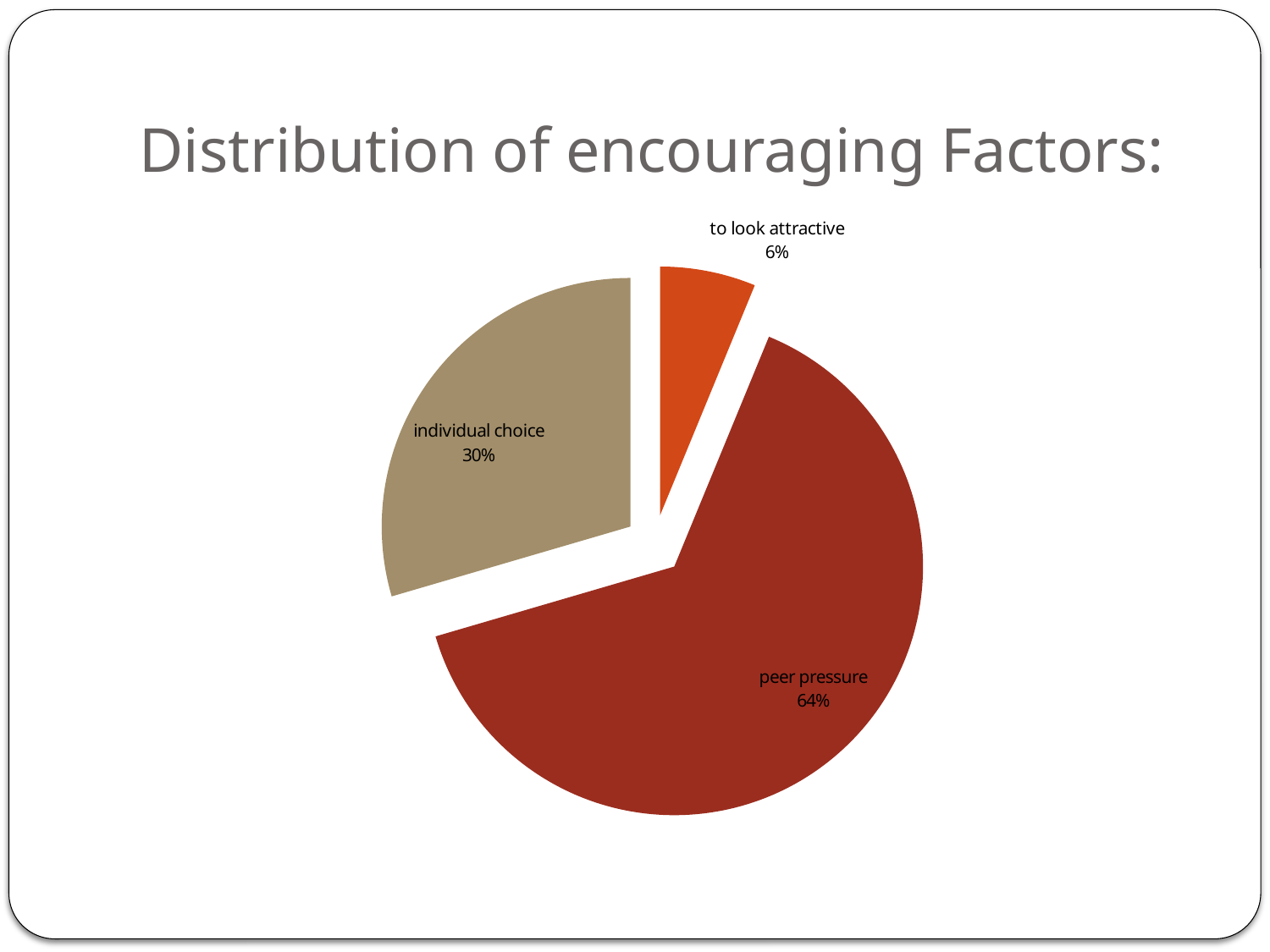
How many slices does the pie chart have? 3 What kind of chart is shown on the slide? pie chart What is the difference in percentage points between individual choice and to look attractive? 24 Which is larger, the share for individual choice or the share for to look attractive? individual choice What is the value shown for to look attractive? 6% What is the value shown for individual choice? 30% Which factor has the smallest share of the pie? to look attractive Which factor has the largest share of the pie? peer pressure What is the title of the chart? Distribution of encouraging Factors: What is the difference in percentage points between peer pressure and individual choice? 34 What colour is the peer pressure slice? dark red What share of the pie does peer pressure account for? 64%